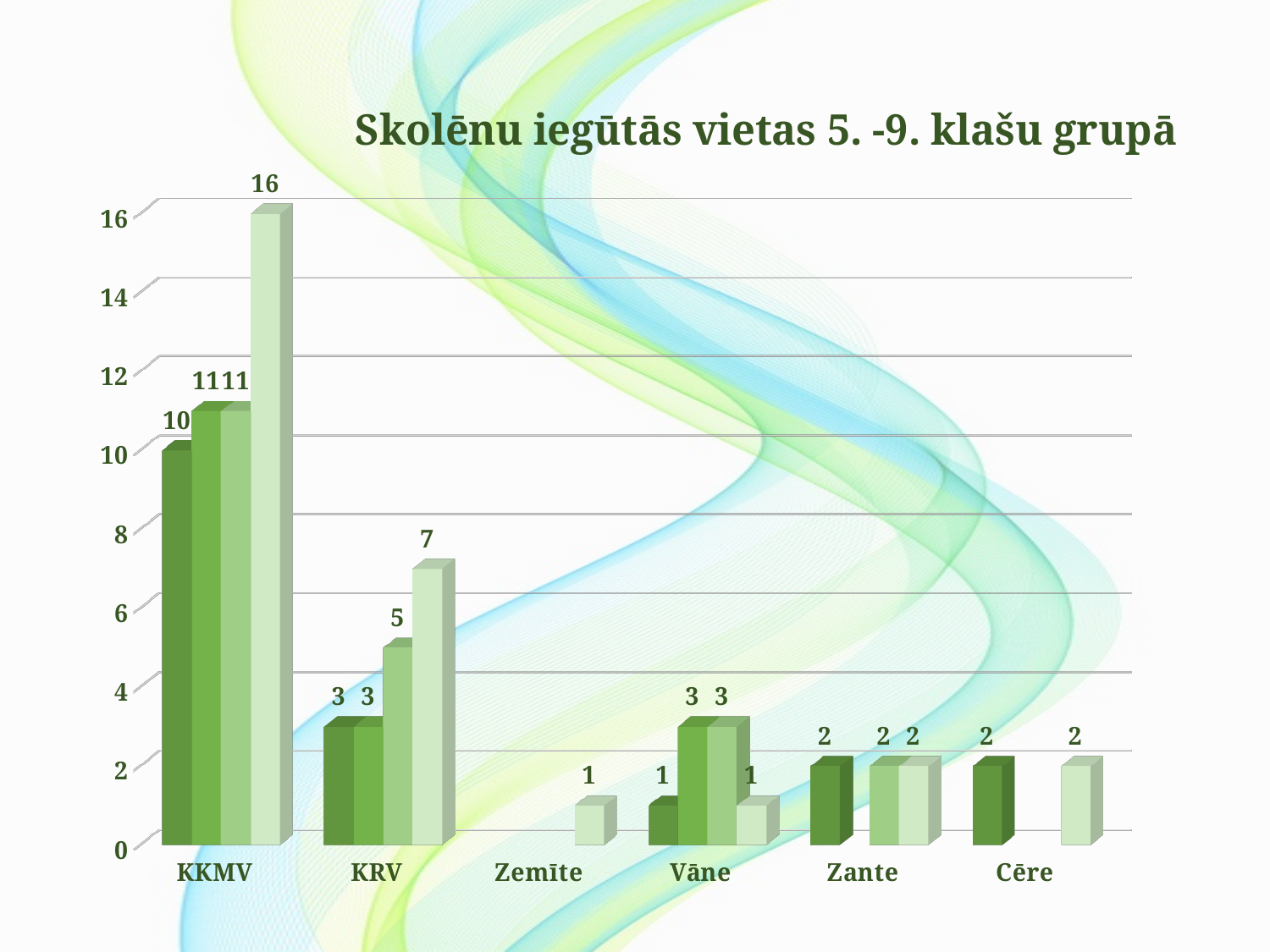
Which category has the highest bar in the chart? KKMV What is the difference between the tallest bar for KKMV and the tallest bar for KRV? 9 What is the value of the tallest bar for KKMV? 16 Which is larger: the tallest bar for Vāne or the tallest bar for KRV? KRV What is the value of the single bar shown for Zemīte? 1 What is the value of the tallest bar for KRV? 7 Which category has the lowest maximum bar value in the chart? Zemīte What kind of chart is shown on the slide? bar chart How many categories are shown on the x axis of the chart? 6 Is the value of the tallest bar for KKMV greater or less than 14? greater What is the value of the darkest green bar for KKMV? 10 What is the title of the chart? Skolēnu iegūtās vietas 5. -9. klašu grupā